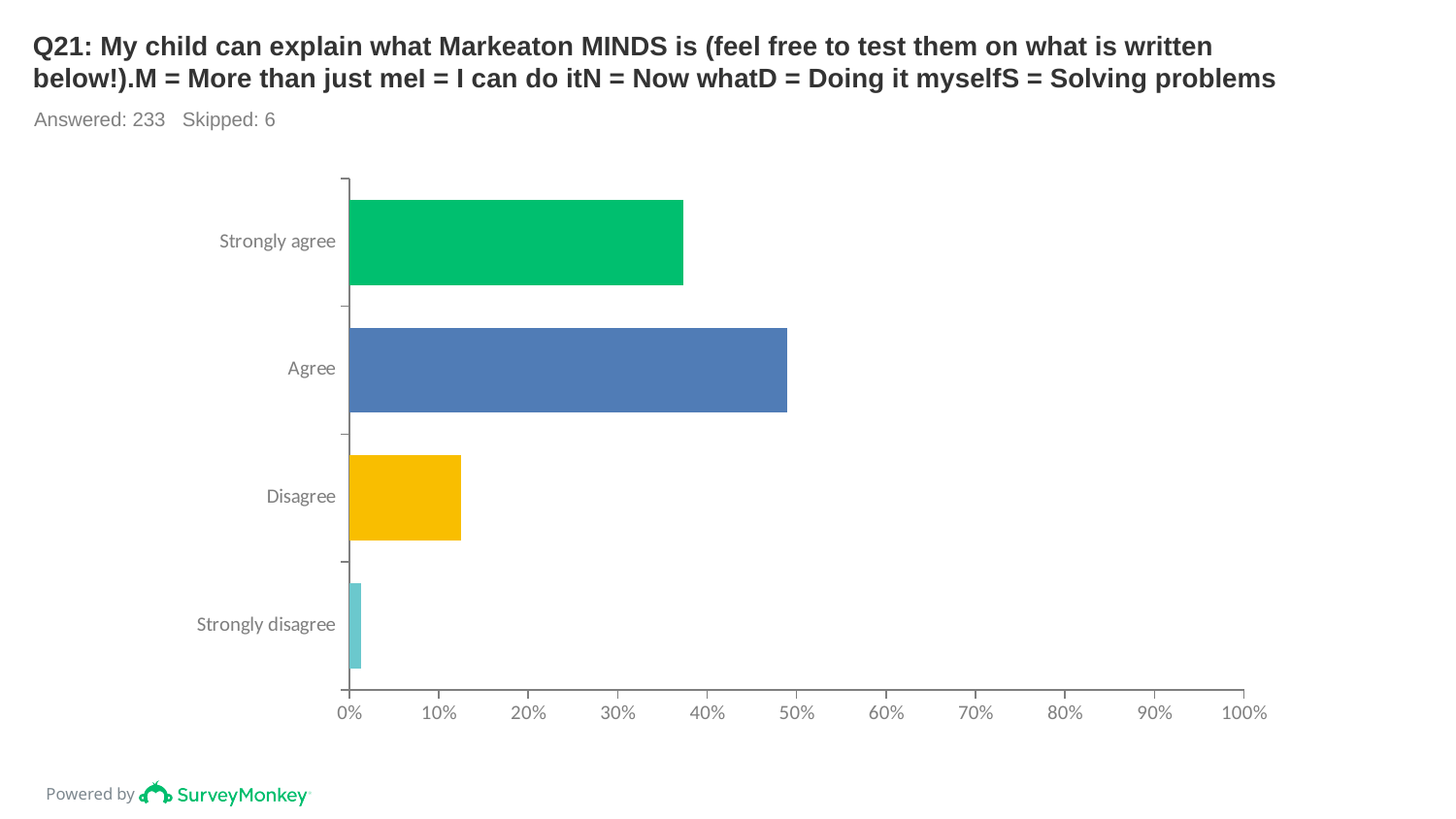
Which is larger, the value for Disagree or the value for Strongly disagree? Disagree Which response category has the lowest value? Strongly disagree How many respondents answered this question according to the slide? 233 Which response category has the highest value? Agree Is the value for Agree greater or less than 40%? greater Is the value for Strongly agree greater or less than 30%? greater Is the value for Strongly agree greater or less than 40%? less What kind of chart is shown on the slide? bar chart How many response categories are shown on the chart? 4 Which is larger, the value for Strongly agree or the value for Agree? Agree